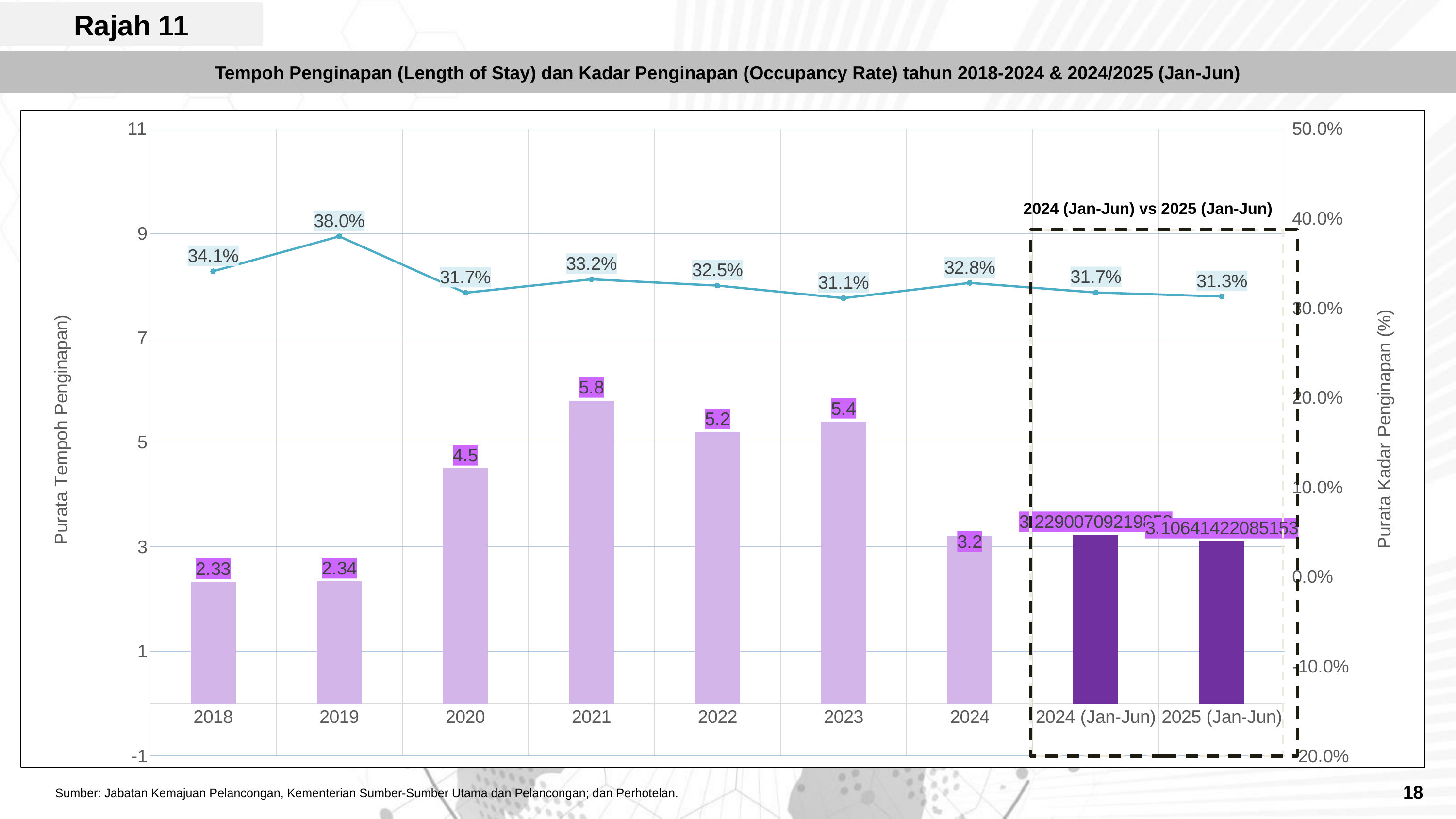
What is the occupancy rate shown for 2019? 38.0% How many categories are shown on the x axis? 9 What is the average length of stay (bar value) for 2018? 2.33 What is the average length of stay (bar value) for 2021? 5.8 Which year has the lowest occupancy rate on the line? 2023 What is the difference between the occupancy rates for 2019 and 2018? 3.9% Which category has the tallest bar for average length of stay? 2021 What is the difference between the bar values for 2021 and 2024? 2.6 Which year has the highest occupancy rate on the line? 2019 What is the occupancy rate shown for 2025 (Jan-Jun)? 31.3% Which is larger, the bar value for 2022 or for 2023? 2023 Is the bar value for 2020 greater or less than 5? less